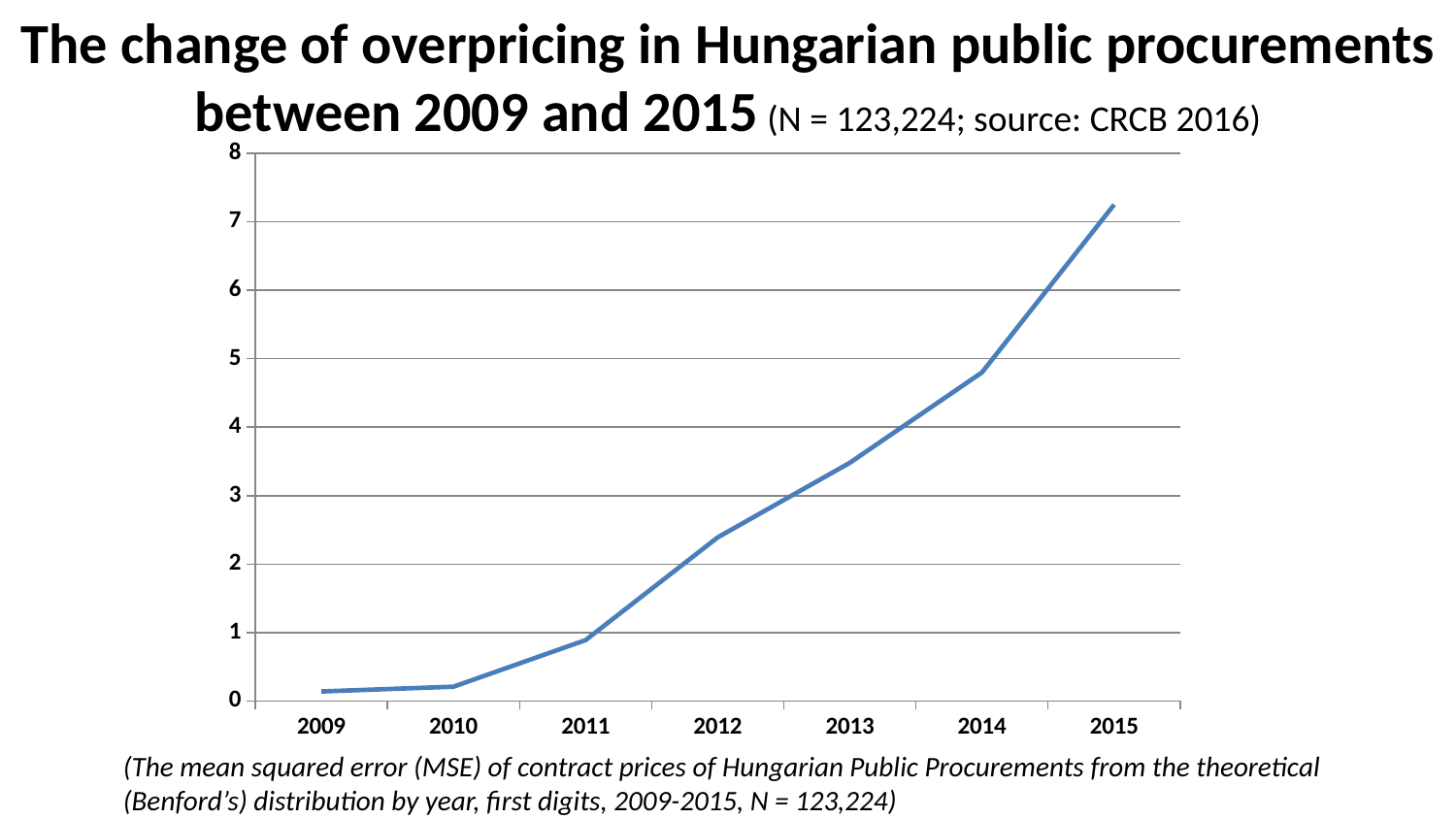
Do the values rise or fall from 2009 to 2015? rise What kind of chart is shown on the slide? line chart Which year has the lowest value? 2009 What is the highest value shown on the y axis? 8 What is the sample size (N) given in the chart title? 123,224 Which is larger, the value for 2013 or the value for 2011? 2013 How many years are plotted on the x axis? 7 Is the value for 2015 greater or less than 7? greater Is the value for 2011 greater or less than 1? less Which year has the highest value? 2015 Is the value for 2012 greater or less than 2? greater